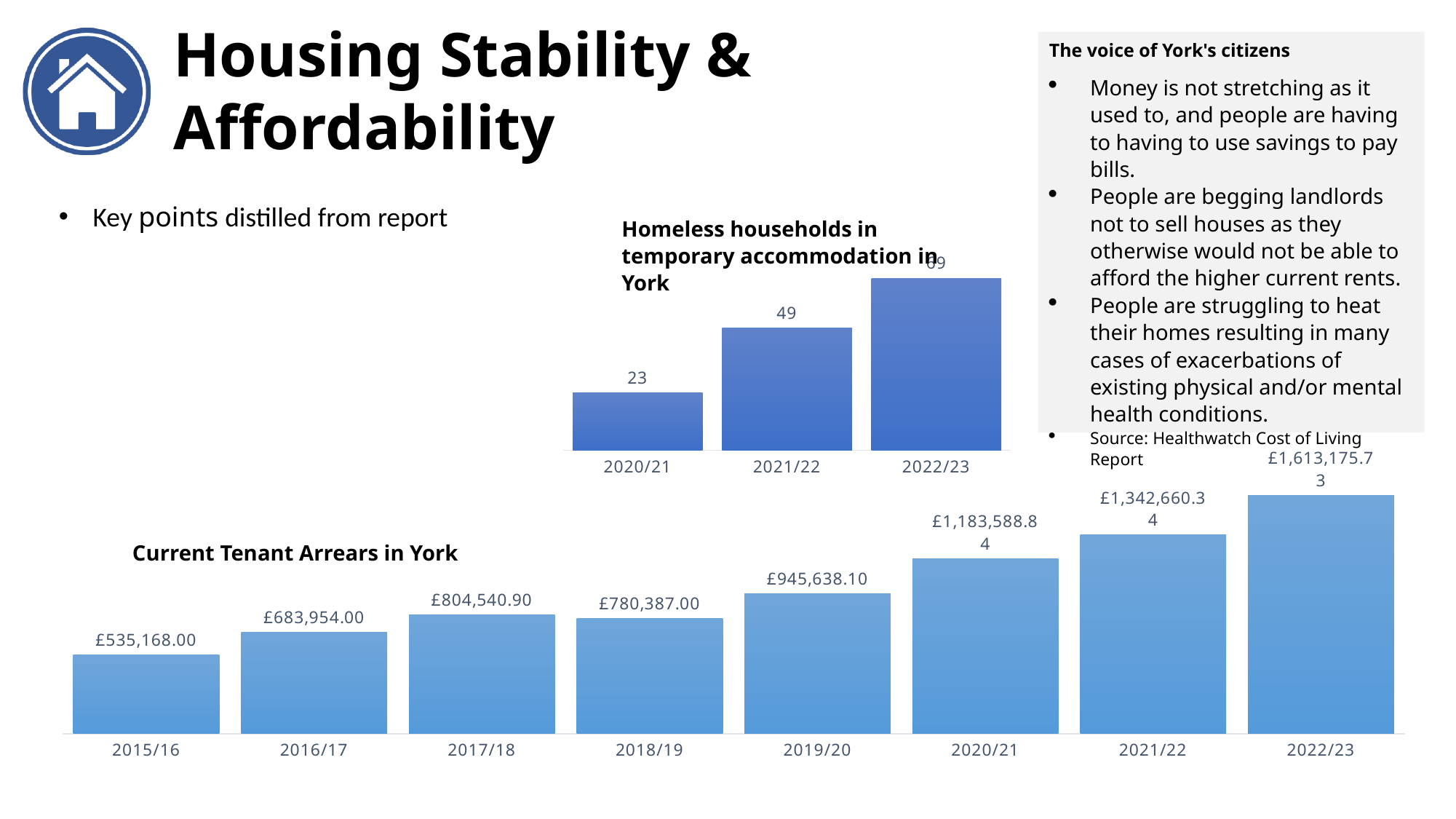
In the 'Current Tenant Arrears in York' chart, which year has the highest value? 2022/23 In the 'Current Tenant Arrears in York' chart, what is the value for 2015/16? £535,168.00 In the 'Homeless households in temporary accommodation in York' chart, what is the value for 2020/21? 23 What kind of chart is 'Current Tenant Arrears in York'? Bar chart In the 'Homeless households in temporary accommodation in York' chart, which year has the highest value? 2022/23 In the 'Current Tenant Arrears in York' chart, how many years are shown? 8 In the 'Homeless households in temporary accommodation in York' chart, what is the difference between 2021/22 and 2020/21? 26 In the 'Current Tenant Arrears in York' chart, which is larger, the value for 2017/18 or 2018/19? 2017/18 In the 'Homeless households in temporary accommodation in York' chart, what is the value for 2021/22? 49 In the 'Current Tenant Arrears in York' chart, what is the value for 2019/20? £945,638.10 In the 'Homeless households in temporary accommodation in York' chart, how many years are shown? 3 In the 'Current Tenant Arrears in York' chart, which year has the lowest value? 2015/16